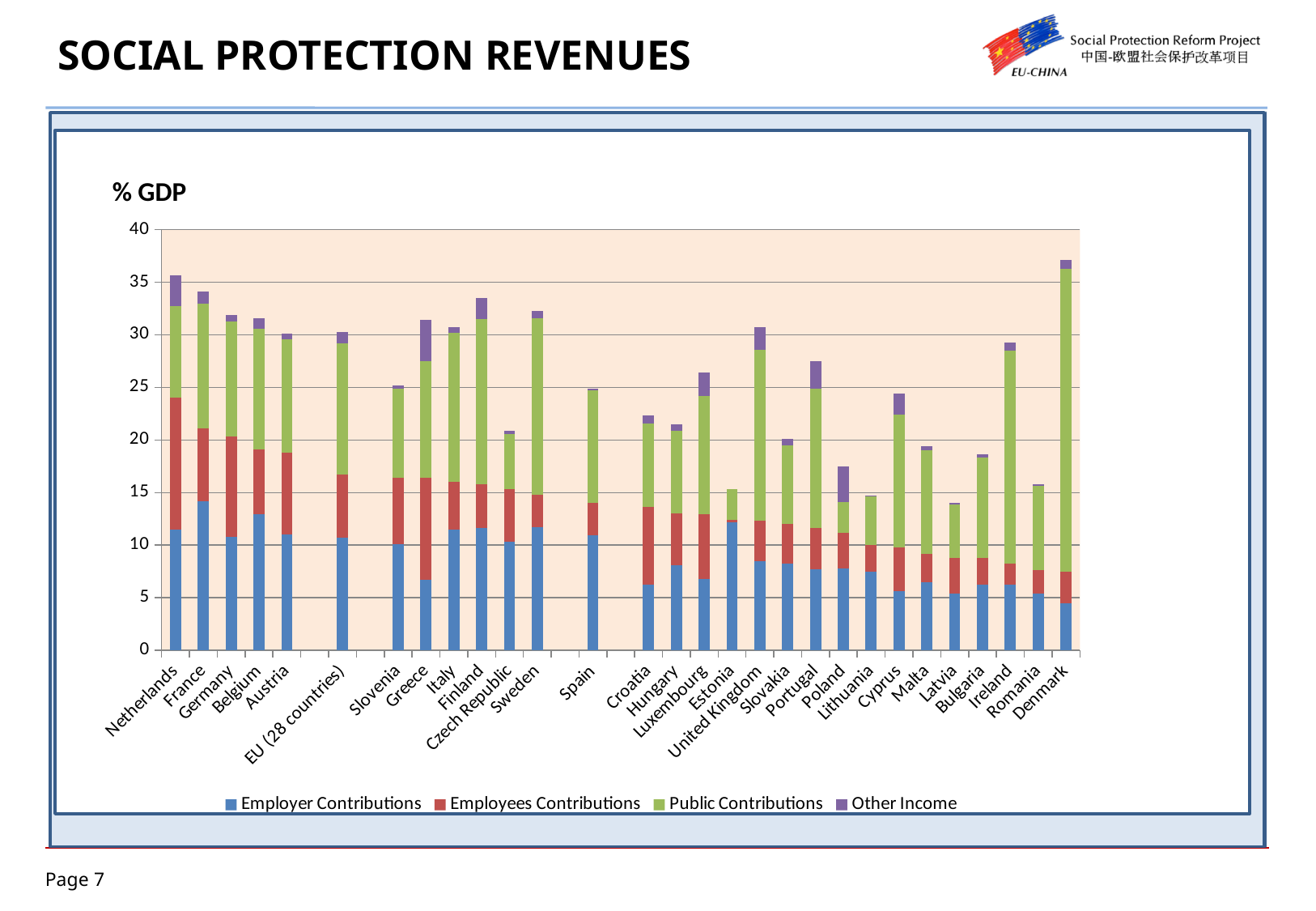
What unit is shown as the label above the y axis? % GDP Is the total value for Denmark greater or less than 35? greater Which has a higher total, the United Kingdom or Portugal? United Kingdom What kind of chart is shown on the slide? Stacked bar chart Which country has the largest Employees Contributions segment? Netherlands How many countries/categories are shown on the x axis? 29 Which country has the largest Employer Contributions segment? France How many series does the legend list? 4 Is the total value for Estonia greater or less than 20? less Which country has the highest total social protection revenues as % of GDP? Denmark Which has a higher total, Netherlands or France? Netherlands Is the Employer Contributions value for Denmark greater or less than 5? less